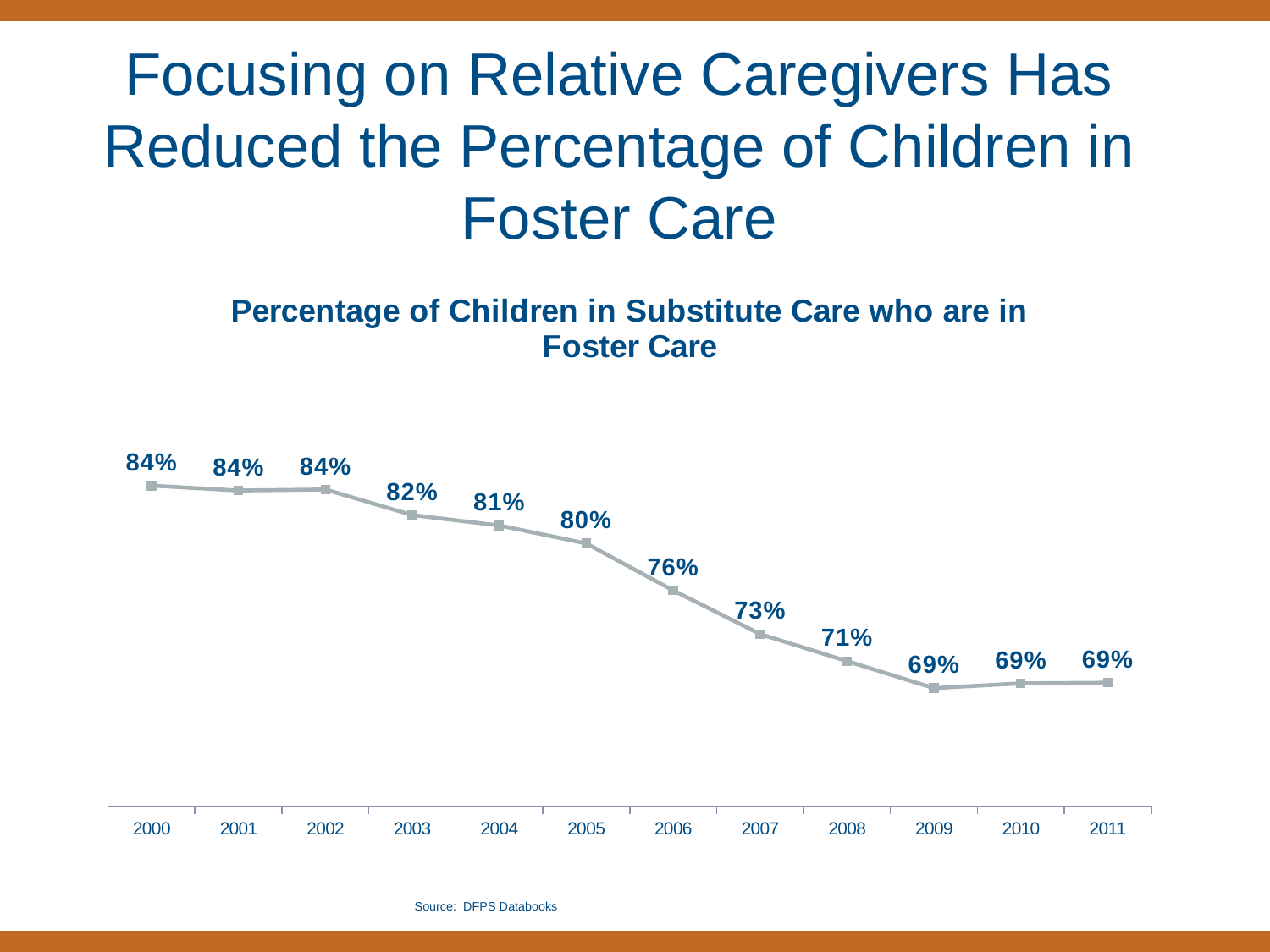
Do the values generally rise or fall from 2000 to 2011? Fall How many years are plotted on the x axis? 12 What is the difference in percentage points between the 2000 value and the 2011 value? 15 percentage points What is the value shown for 2011? 69% What is the value shown for 2006? 76% What percentage of children in substitute care were in foster care in 2000? 84% What is the value shown for 2003? 82% What kind of chart is shown on the slide? Line chart What source is cited for the chart data? DFPS Databooks What is the difference in percentage points between 2005 and 2006? 4 percentage points What is the title of the chart? Percentage of Children in Substitute Care who are in Foster Care Which is larger, the value for 2004 or the value for 2007? 2004